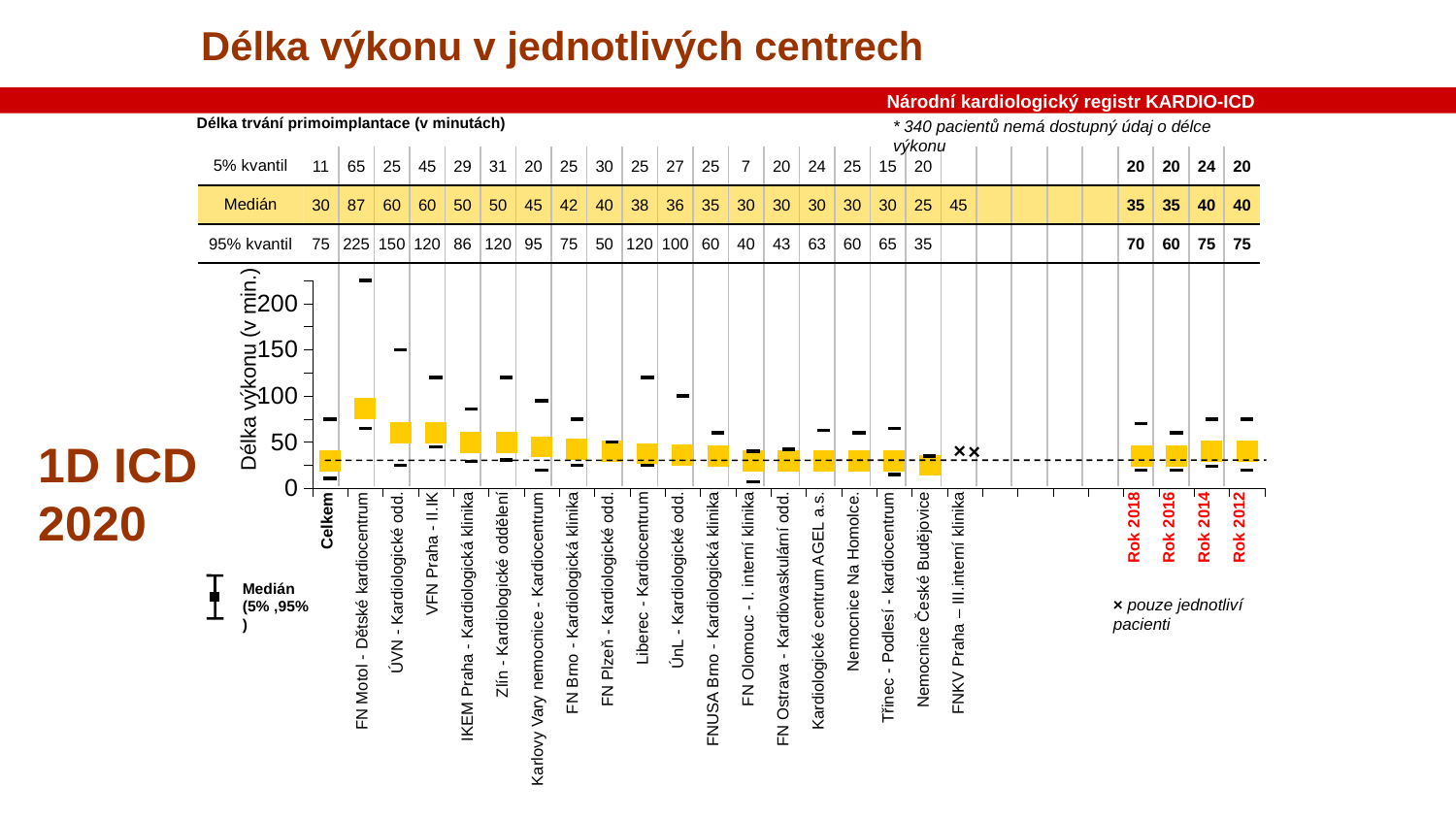
What is the Medián value for Rok 2012? 40 Which has the larger Medián value: Zlín - Kardiologické oddělení or Karlovy Vary nemocnice - Kardiocentrum? Zlín - Kardiologické oddělení What is the difference between the 95% kvantil and the 5% kvantil for Celkem? 64 What is the label of the vertical axis? Délka výkonu (v min.) What is the difference between the Medián for FN Motol - Dětské kardiocentrum and the Medián for Celkem? 57 What is the 95% kvantil value for FN Motol - Dětské kardiocentrum? 225 Which centre has the lowest 5% kvantil value? FN Olomouc - I. interní klinika What is the Medián value for FN Motol - Dětské kardiocentrum? 87 Which centre has the highest Medián value? FN Motol - Dětské kardiocentrum Which centre has the lowest Medián value? Nemocnice České Budějovice What is the Medián value for Celkem? 30 What is the 95% kvantil value for Rok 2018? 70